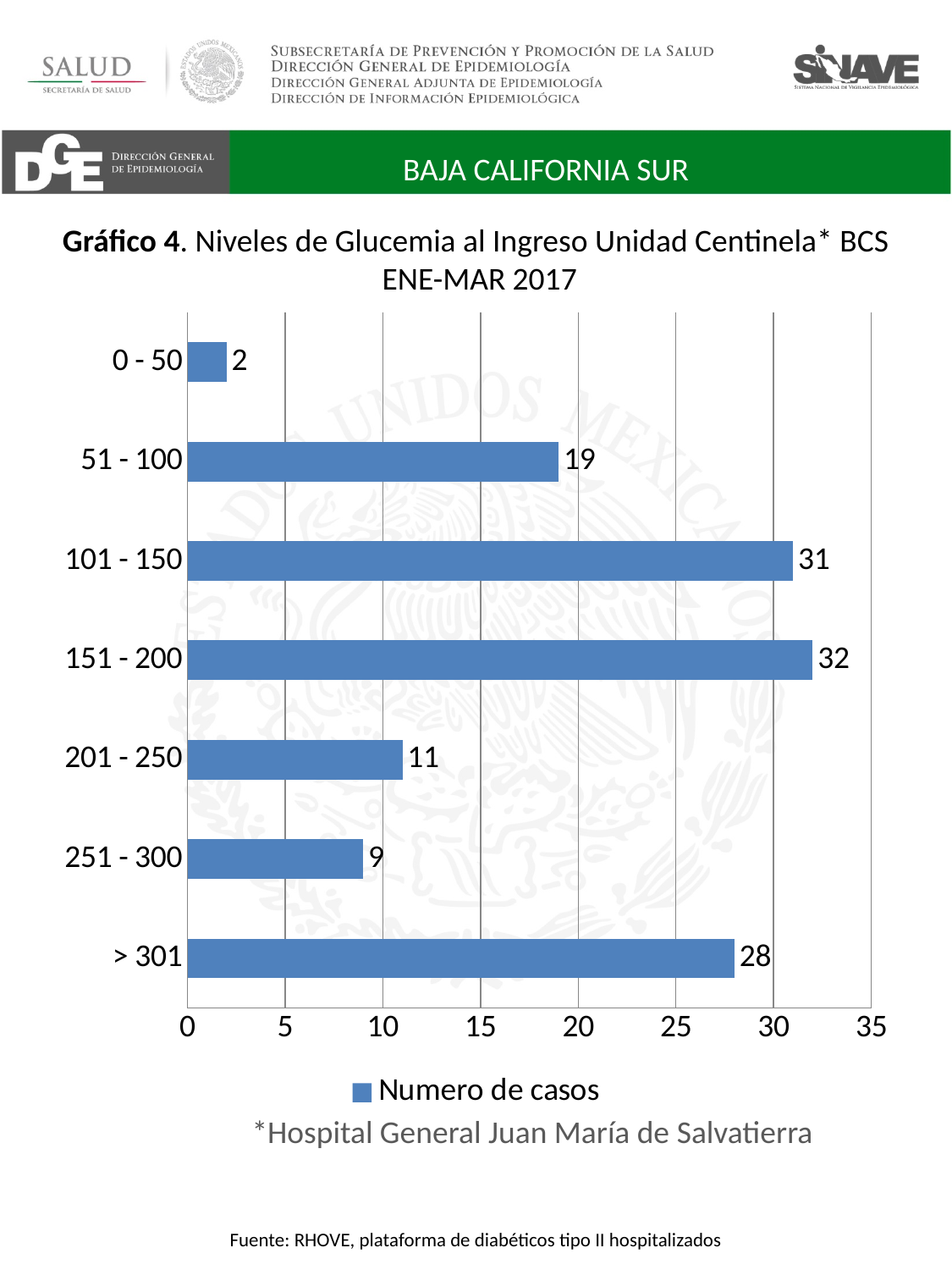
Which glucose level category has the lowest number of cases? 0 - 50 What is the name of the series shown in the legend? Numero de casos What is the number of cases for the 0 - 50 category? 2 Which has more cases, the 51 - 100 category or the 251 - 300 category? 51 - 100 Is the value for the 201 - 250 category greater or less than 15? less What kind of chart is shown on the slide? Bar chart Which glucose level category has the highest number of cases? 151 - 200 What is the number of cases for the > 301 category? 28 What is the number of cases for the 101 - 150 glucose level category? 31 What is the difference in number of cases between the 151 - 200 and 201 - 250 categories? 21 How many series does the legend list? 1 How many glucose level categories are shown in the chart? 7